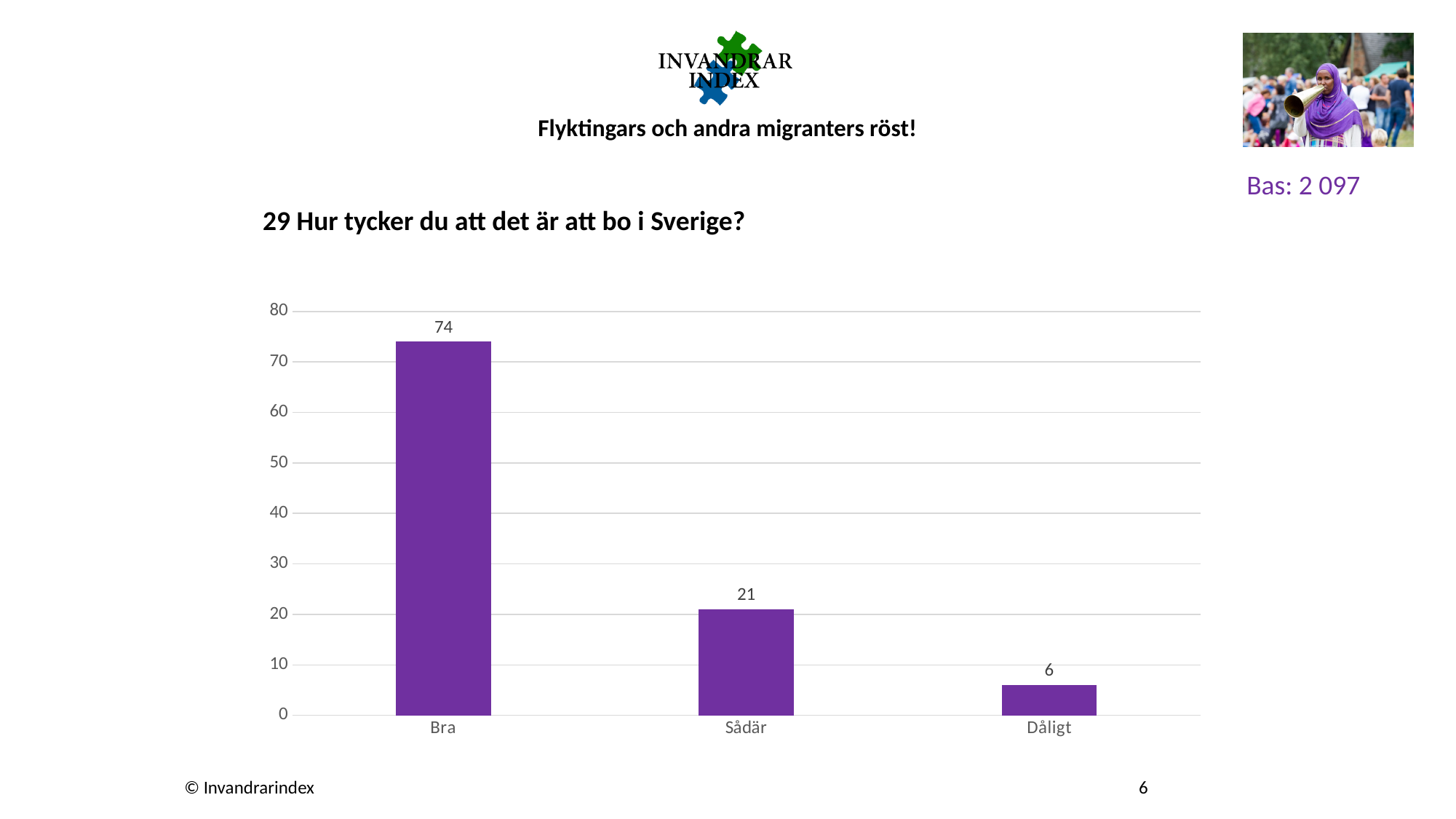
What kind of chart is shown on the slide? bar chart What is the value for Sådär? 21 What is the title of the chart? 29 Hur tycker du att det är att bo i Sverige? Which category has the lowest value? Dåligt Is the value for Bra greater or less than 70? greater Which category has the highest value? Bra What is the value for Bra? 74 What is the difference between the values for Sådär and Dåligt? 15 Which is larger, the value for Sådär or the value for Dåligt? Sådär What is the value for Dåligt? 6 What is the difference between the values for Bra and Sådär? 53 How many categories are shown on the x axis? 3